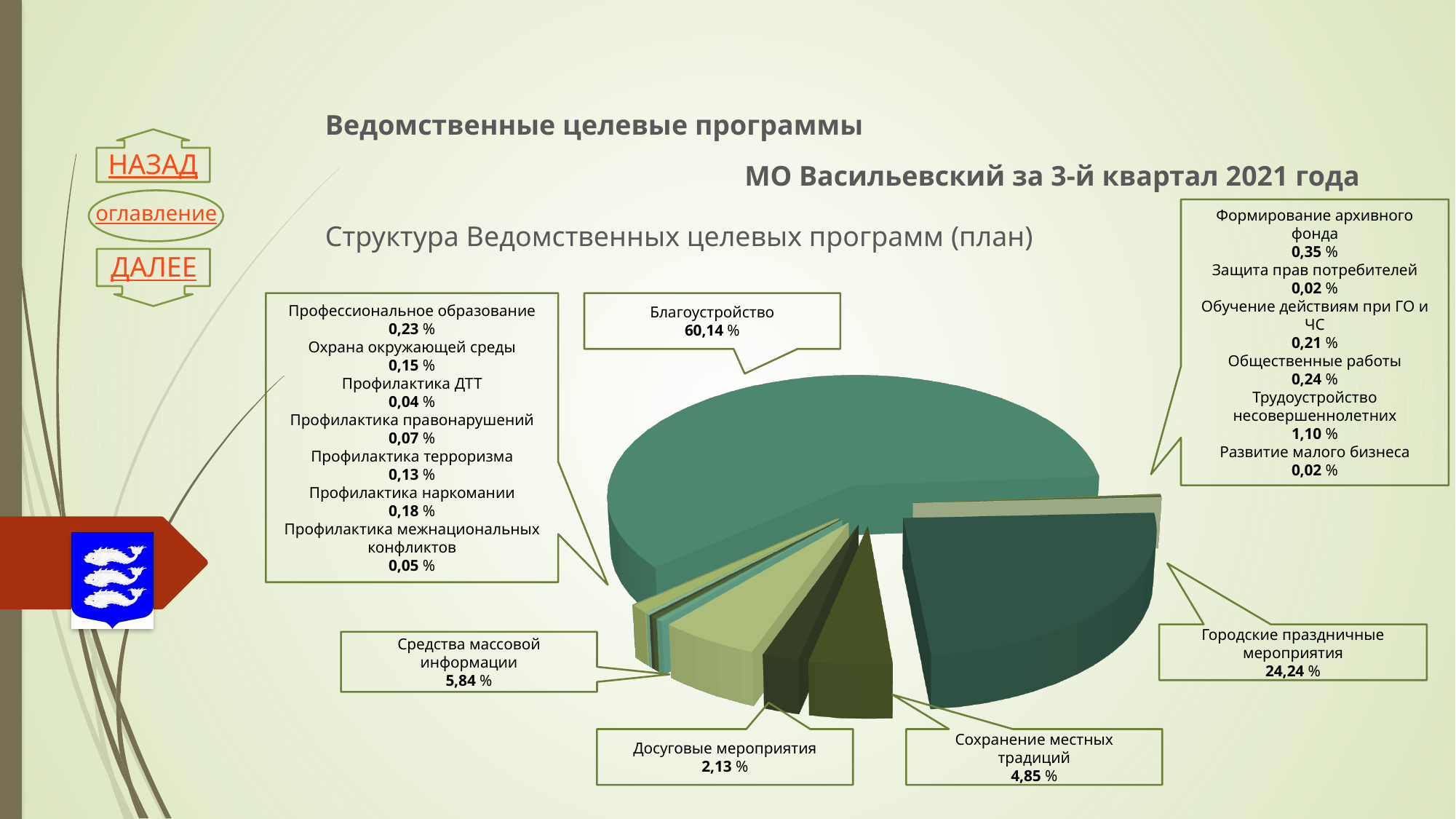
What is the title of the chart? Структура Ведомственных целевых программ (план) What is the difference between Средства массовой информации and Сохранение местных традиций? 0,99 % How many categories are labelled on the pie chart? 18 What value is given for Профилактика ДТТ? 0,04 % What share of the pie chart does Благоустройство account for? 60,14 % Which is larger: Досуговые мероприятия or Сохранение местных традиций? Сохранение местных традиций What is the value shown for Городские праздничные мероприятия? 24,24 % What is the value for Трудоустройство несовершеннолетних? 1,10 % What percentage is labelled for Средства массовой информации? 5,84 % Which category has the largest share of the pie chart? Благоустройство What type of chart is shown on the slide? Pie chart What is the difference between the shares of Благоустройство and Городские праздничные мероприятия? 35,90 %